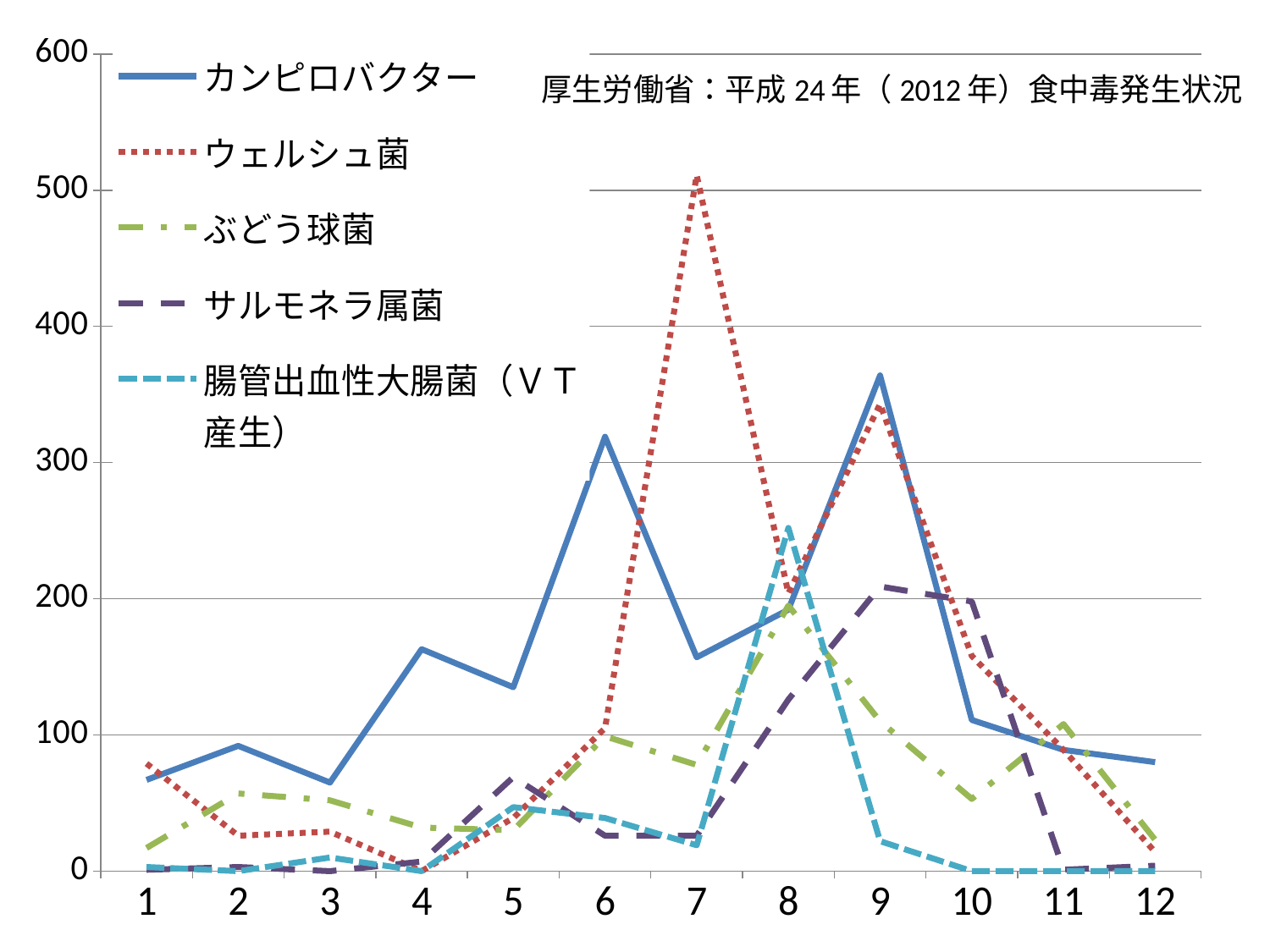
Which series is drawn as a solid blue line? カンピロバクター How many series does the legend list? 5 Does the カンピロバクター line rise or fall from month 9 to month 12? fall What kind of chart is shown on the slide? line chart Is the value for ウェルシュ菌 in month 7 greater or less than 400? greater Is the value for カンピロバクター in month 9 greater or less than 300? greater In month 6, which is larger: カンピロバクター or ウェルシュ菌? カンピロバクター Is the value for サルモネラ属菌 in month 8 greater or less than 200? less In which month does the カンピロバクター line reach its highest value? 9 In which month does the ウェルシュ菌 line reach its highest value? 7 How many points are there along the x axis? 12 In which month does the 腸管出血性大腸菌（ＶＴ産生） line reach its highest value? 8